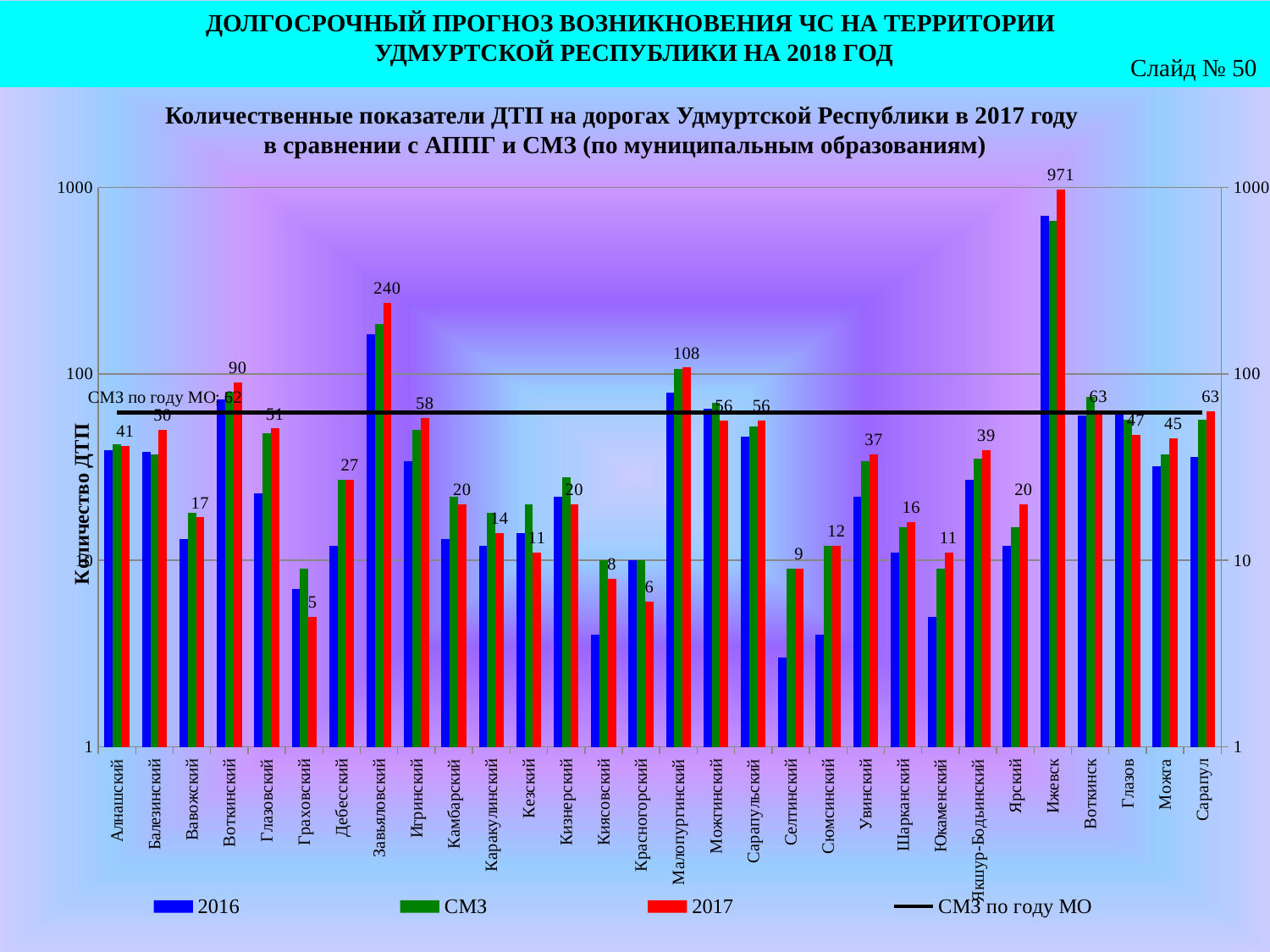
What is the 2017 value for Граховский? 5 What is the 2017 value for Завьяловский? 240 What value does the horizontal line 'СМЗ по году МО' mark? 62 What is the difference between the 2017 values for Ижевск and Завьяловский? 731 Which category has the lowest 2017 value? Граховский What kind of chart is shown on the slide? bar chart How many municipal entities (categories) are shown on the x axis? 30 What is the 2017 value for Ижевск? 971 Which category has the highest 2017 value? Ижевск Is the 2016 value for Селтинский greater or less than 10? less How many series does the legend list? 4 Which has the larger 2017 value, Малопургинский or Воткинский? Малопургинский